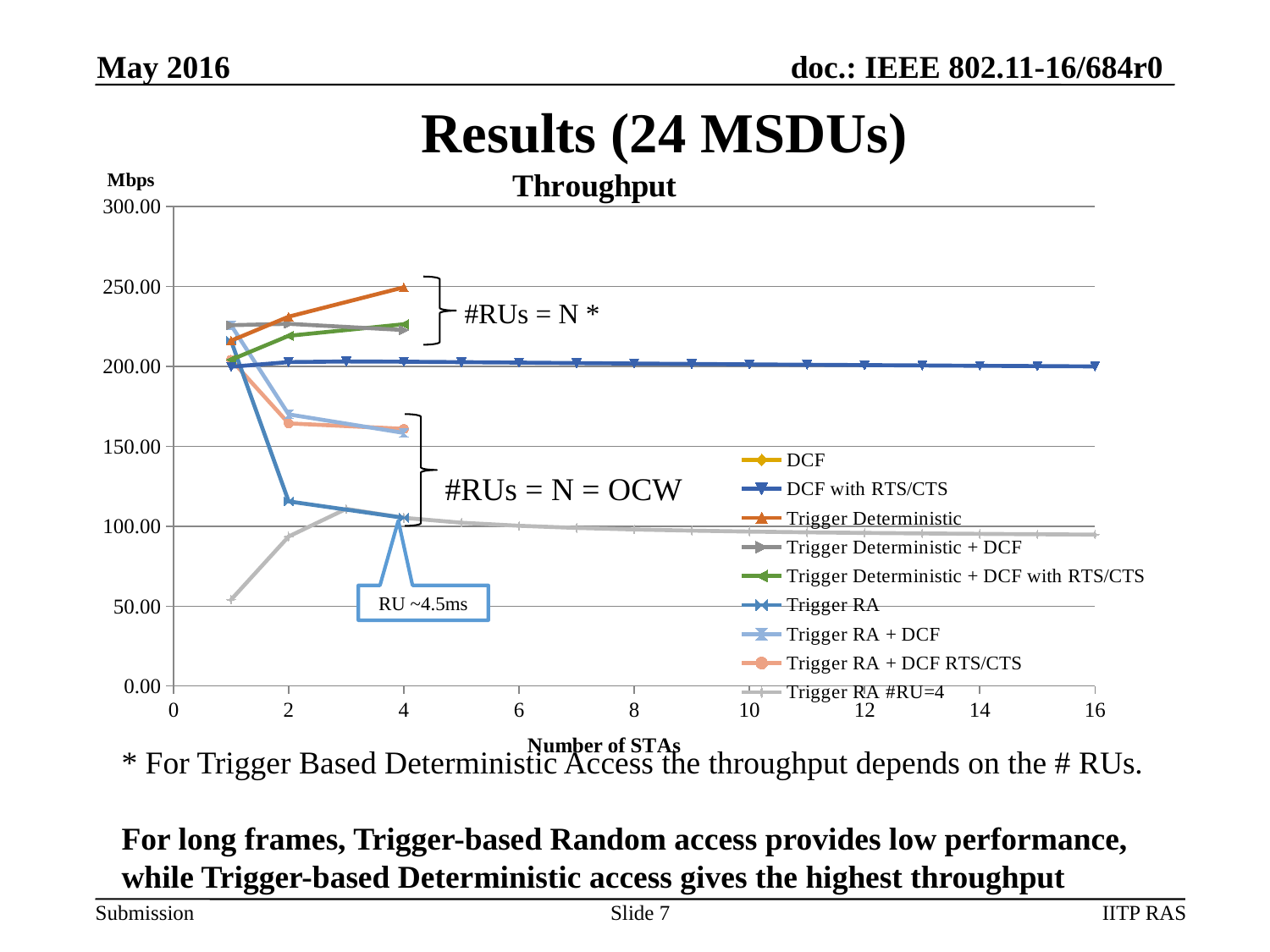
What is the label of the x axis of the chart? Number of STAs What is the title of the chart? Throughput Is the value for Trigger RA at 4 STAs greater or less than 150? less How many series does the legend of the Throughput chart list? 9 What kind of chart is shown on the slide? line chart Is the value for DCF with RTS/CTS at 16 STAs greater or less than 150? greater Is the value for Trigger RA #RU=4 at 1 STA greater or less than 100? less Does the Trigger RA series rise or fall as the number of STAs increases from 1 to 4? fall Does the Trigger Deterministic series rise or fall as the number of STAs increases from 1 to 4? rise At 4 STAs, which series has the higher throughput: Trigger Deterministic or Trigger RA? Trigger Deterministic Which series has the lowest throughput at 1 STA? Trigger RA #RU=4